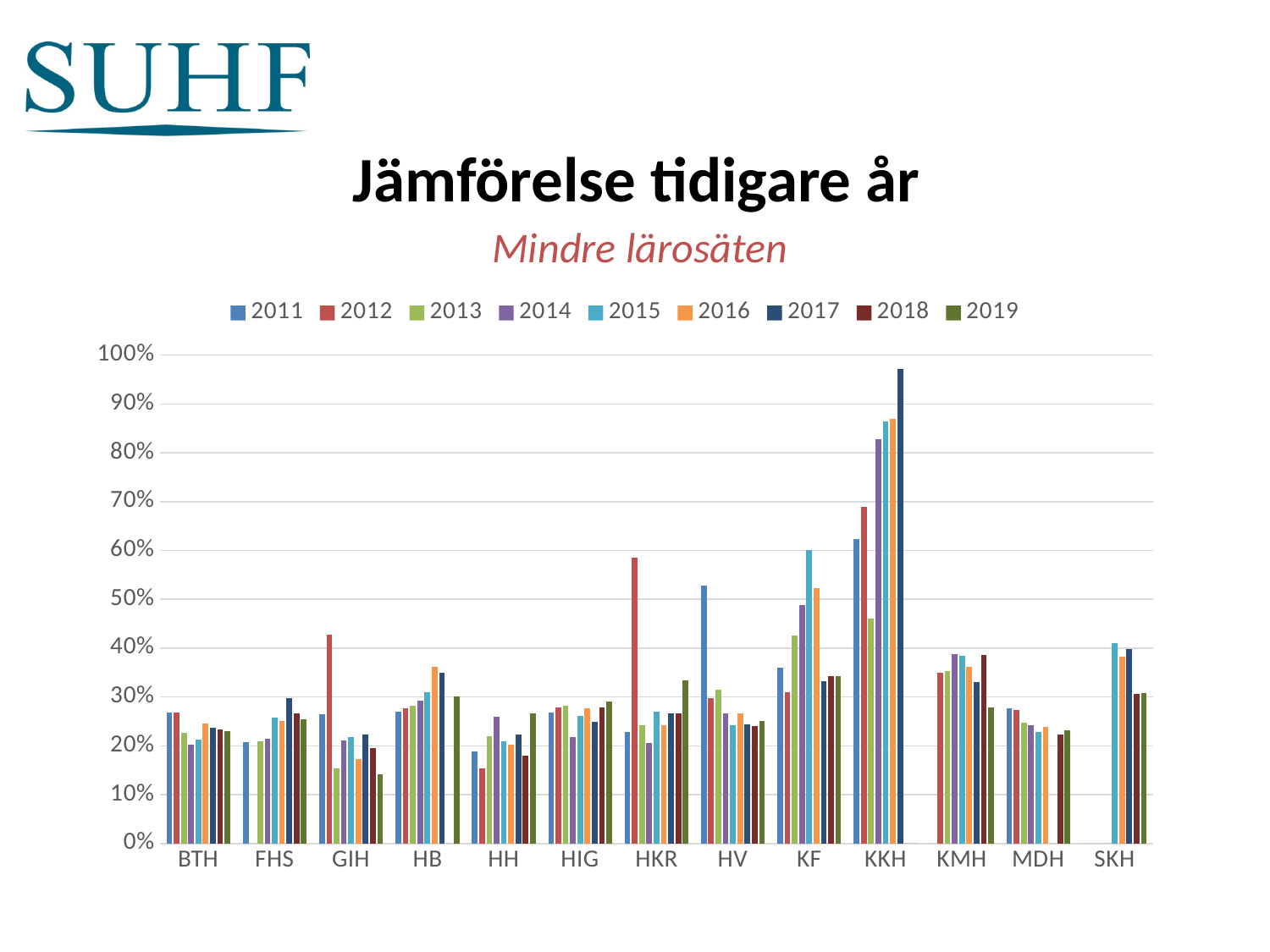
How many categories are shown on the x axis? 13 Which year has the highest value for KF? 2015 Which year has the highest value for HKR? 2012 Which is larger for GIH: the value for 2012 or the value for 2019? 2012 Is the value for KF in 2015 greater or less than 50%? greater What kind of chart is shown on the slide? bar chart Is the value for HKR in 2012 greater or less than 50%? greater What is the title of the chart? Jämförelse tidigare år Is the value for GIH in 2013 greater or less than 20%? less How many series does the legend list? 9 Which category has the highest bar in the whole chart? KKH